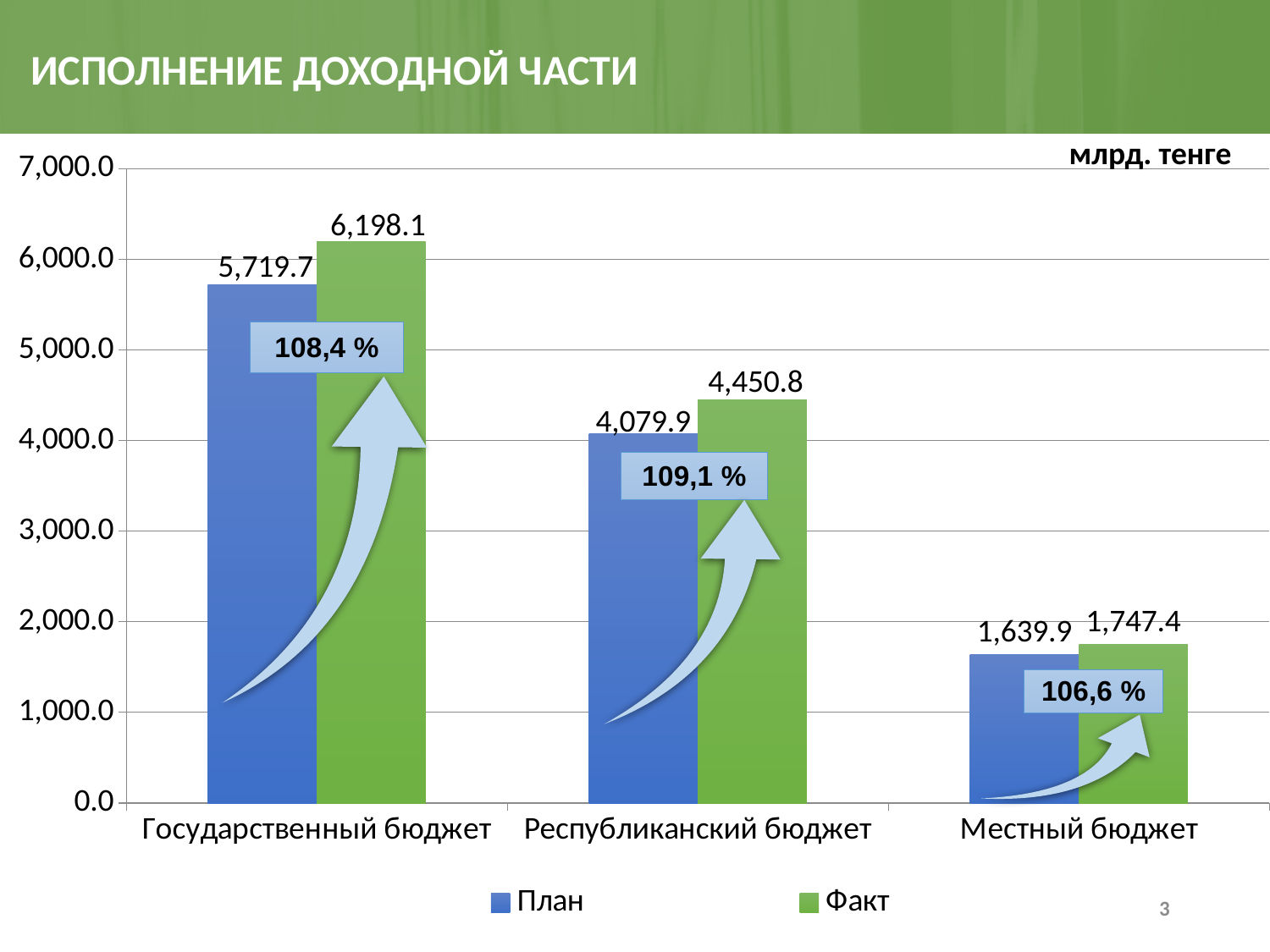
Which is larger for Местный бюджет: the План value or the Факт value? Факт How many categories are shown on the x axis? 3 What is the Факт value for Республиканский бюджет? 4,450.8 What is the План value for Государственный бюджет? 5,719.7 Which category has the lowest План value? Местный бюджет What type of chart is shown on the slide? Bar chart What is the difference between the Факт and План values for Государственный бюджет? 478.4 What is the План value for Местный бюджет? 1,639.9 How many series does the legend list? 2 What is the Факт value for Местный бюджет? 1,747.4 What is the difference between the Факт and План values for Республиканский бюджет? 370.9 Which category has the highest Факт value? Государственный бюджет